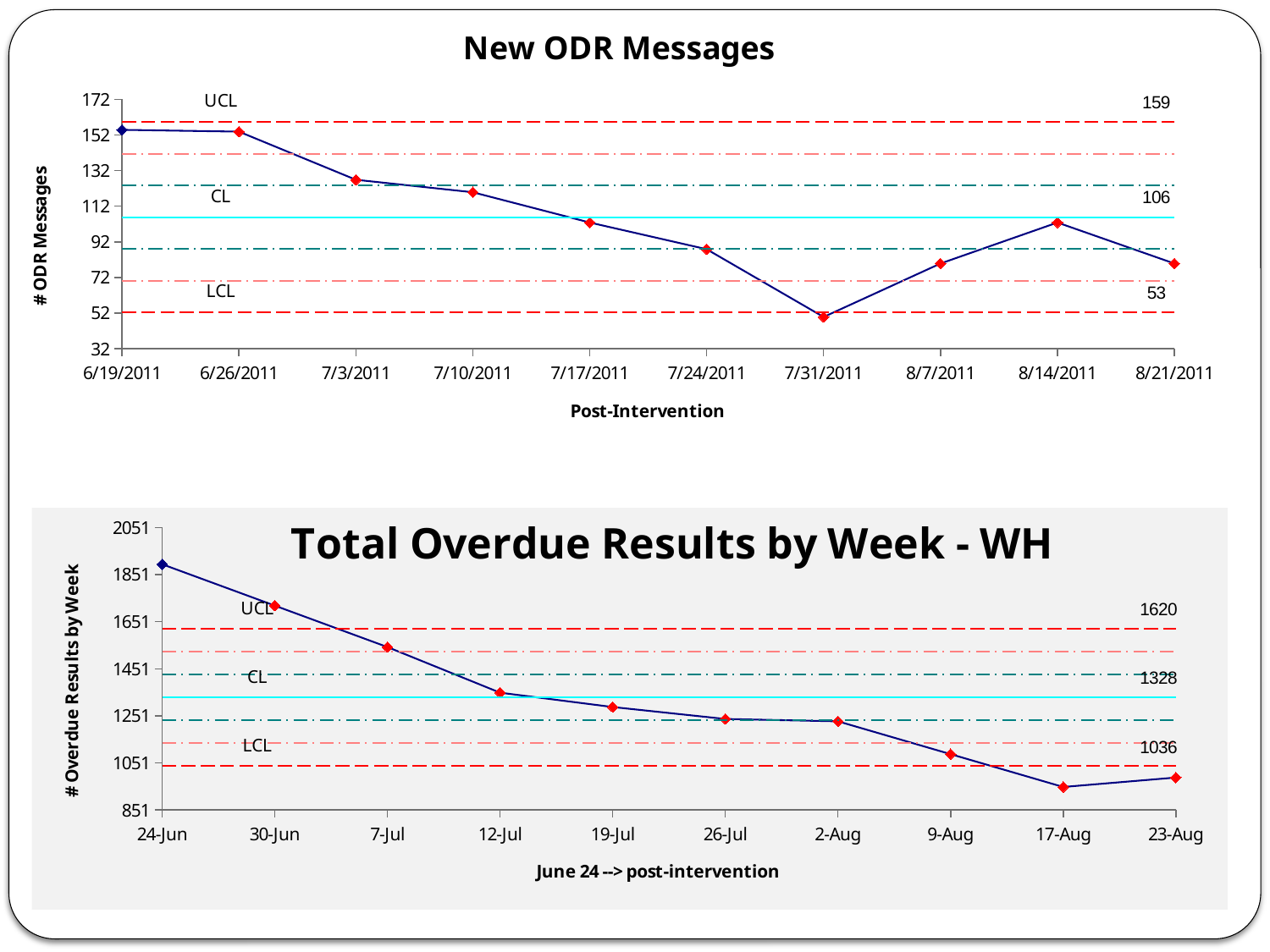
On the New ODR Messages chart, what is the difference between the UCL and LCL values? 106 On the New ODR Messages chart, is the value for 7/3/2011 greater or less than 112? greater On the New ODR Messages chart, which date has the lowest number of ODR messages? 7/31/2011 On the Total Overdue Results by Week - WH chart, which week has the highest number of overdue results? 24-Jun On the New ODR Messages chart, what is the value of the UCL line? 159 On the Total Overdue Results by Week - WH chart, what is the value of the LCL line? 1036 On the Total Overdue Results by Week - WH chart, what is the value of the UCL line? 1620 What kind of chart is the Total Overdue Results by Week - WH chart? line chart On the New ODR Messages chart, what is the value of the CL line? 106 On the New ODR Messages chart, what is the value of the LCL line? 53 On the New ODR Messages chart, how many dates are plotted on the x axis? 10 On the Total Overdue Results by Week - WH chart, is the value for 17-Aug greater or less than 1051? less